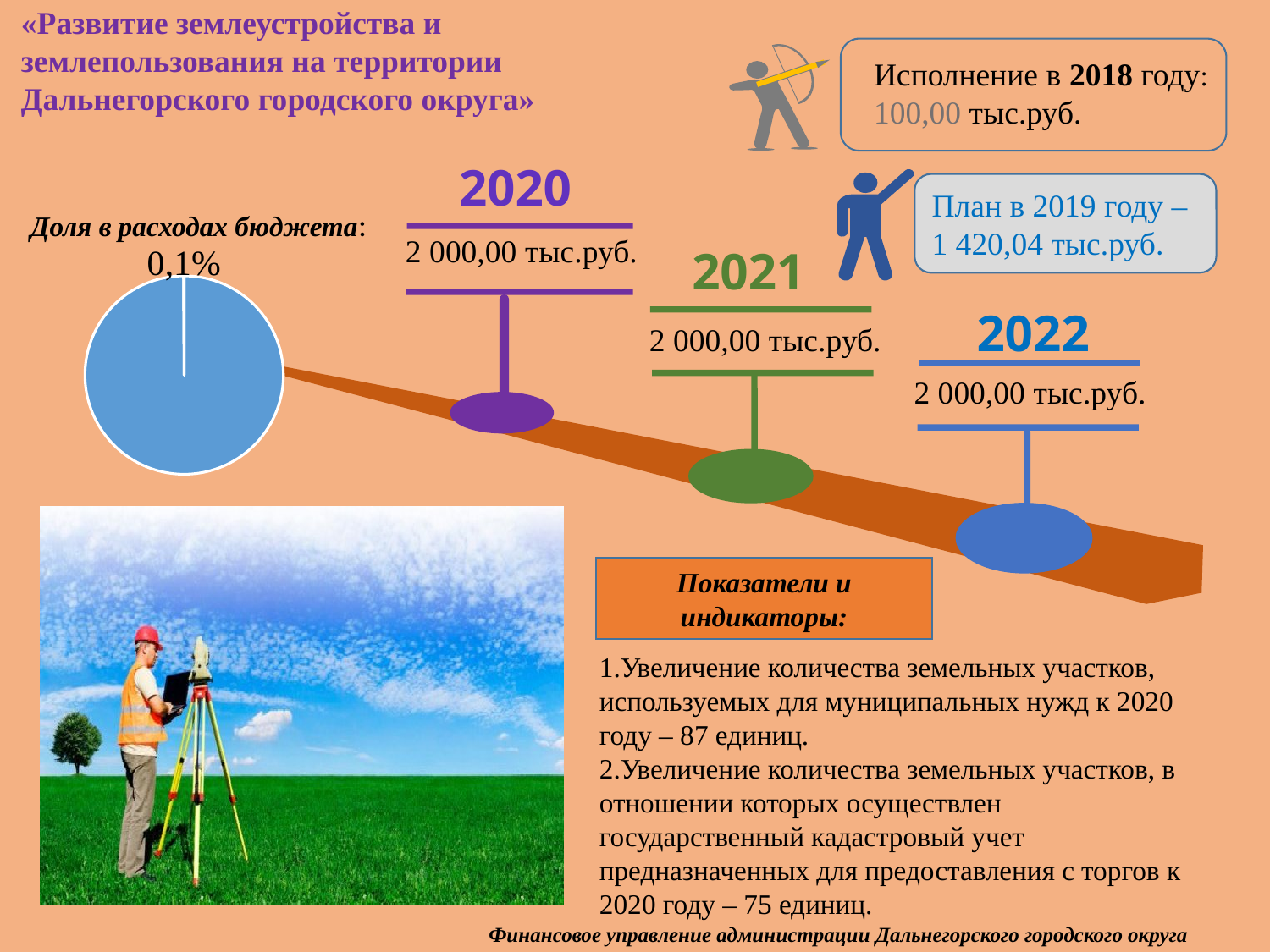
What share value is printed on the pie chart? 0,1% Which slice of the pie chart is larger: the slice labelled 0,1% or the unlabelled remaining slice? the unlabelled remaining slice How many slices does the pie chart contain? 2 Does the pie chart show a legend? No What heading is printed above the pie chart? Доля в расходах бюджета What colour is the large slice of the pie chart? blue What kind of chart is shown under the heading «Доля в расходах бюджета»? pie chart